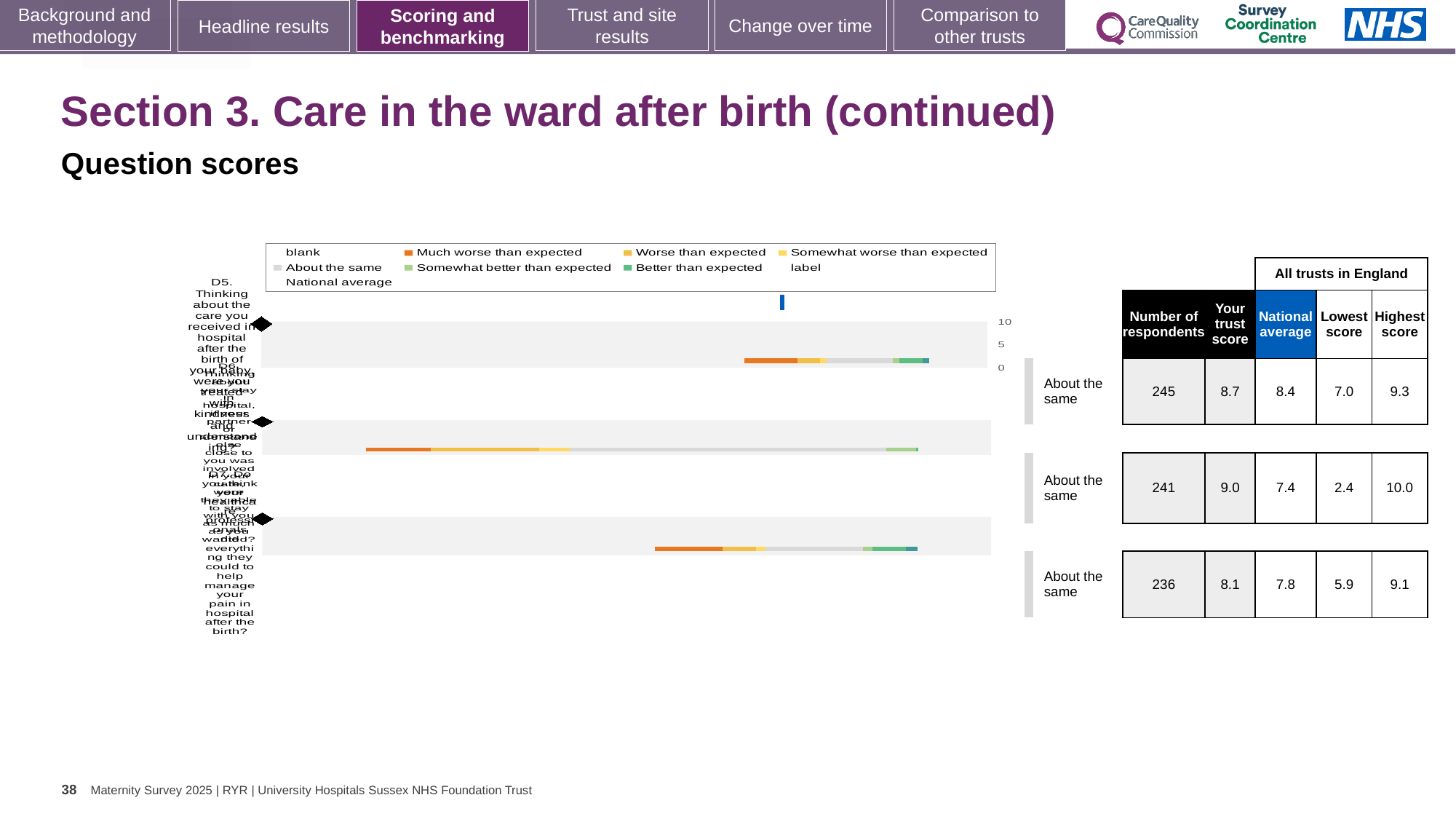
In the table beside the chart, what is the difference between 'Your trust score' and the national average in the second row? 1.6 What kind of chart is shown on the slide? bar chart In the table beside the chart, which row has the largest number of respondents? first row (245) How many bars (question rows) does the chart show? 3 In the table beside the chart, what is the highest score in the second row? 10.0 What is the highest tick value shown on the chart's numeric axis? 10 In the table beside the chart, what is the lowest score in the third row? 5.9 In the table beside the chart, what is the number of respondents in the first row? 245 In the chart legend, what colour represents 'Much worse than expected'? orange What benchmark label is shown next to each of the three bars? About the same In the table beside the chart, what is 'Your trust score' in the second row? 9.0 In the table beside the chart, in the third row, which is larger: 'Your trust score' or the national average? Your trust score